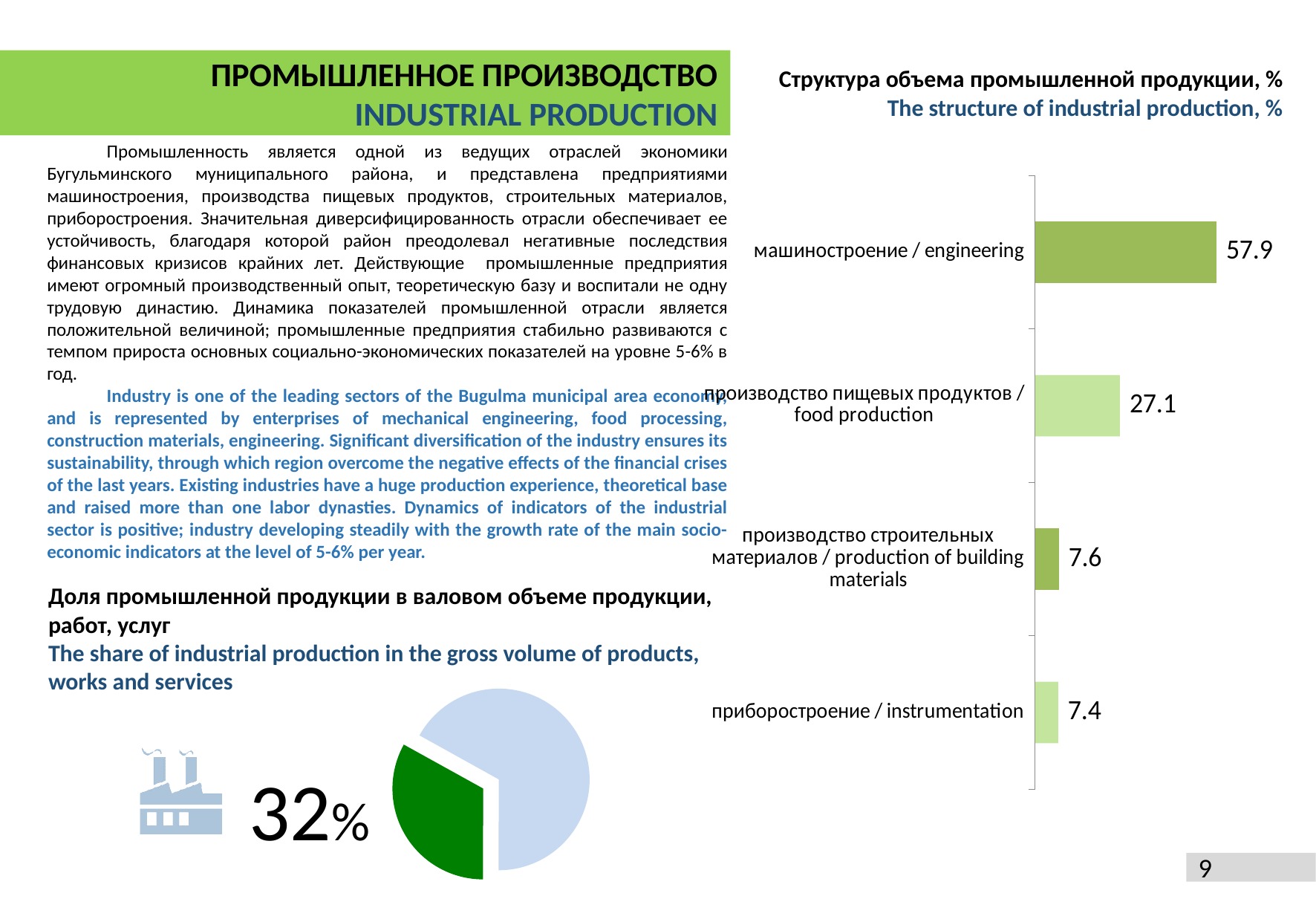
How many categories are shown in the chart 'The structure of industrial production, %'? 4 In the chart 'The structure of industrial production, %', what is the value for production of building materials? 7.6 What kind of chart is 'The structure of industrial production, %'? bar chart In the chart 'The structure of industrial production, %', what is the difference between the values for engineering and food production? 30.8 In the chart 'The structure of industrial production, %', what is the value for food production? 27.1 In the chart 'The structure of industrial production, %', what is the value for instrumentation? 7.4 In the chart 'The structure of industrial production, %', which category has the lowest value? приборостроение / instrumentation In the pie chart at the bottom left of the slide, what share of the gross volume of products, works and services does industrial production account for? 32% In the chart 'The structure of industrial production, %', which is larger: the value for food production or the value for production of building materials? food production What kind of chart is shown at the bottom left of the slide next to the factory icon? pie chart In the chart 'The structure of industrial production, %', which category has the highest value? машиностроение / engineering In the chart 'The structure of industrial production, %', what is the value for engineering? 57.9